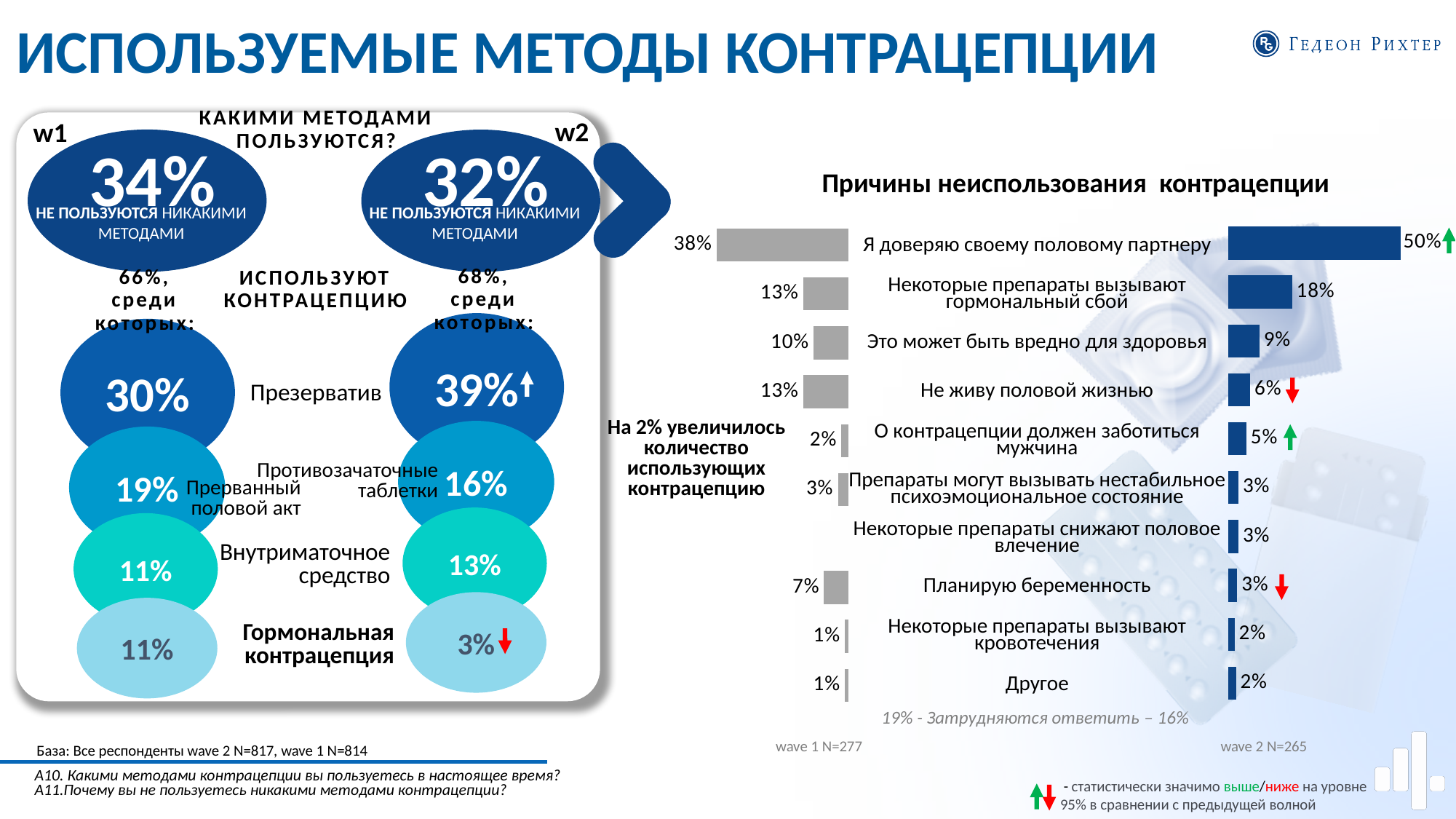
In the chart 'Причины неиспользования контрацепции', what is the wave 1 value for 'Не живу половой жизнью'? 13% In the left infographic 'Какими методами пользуются?', what share of respondents in w2 use no contraception methods? 32% In the chart 'Причины неиспользования контрацепции', what is the sample size shown for wave 2? N=265 What kind of chart is 'Причины неиспользования контрацепции'? bar chart In the chart 'Причины неиспользования контрацепции', what is the wave 1 value for 'Планирую беременность'? 7% In the chart 'Причины неиспользования контрацепции', what is the wave 2 value for 'Я доверяю своему половому партнеру'? 50% In the chart 'Причины неиспользования контрацепции', which reason has the highest wave 2 value? Я доверяю своему половому партнеру In the chart 'Причины неиспользования контрацепции', how many waves (series) are compared? 2 In the chart 'Причины неиспользования контрацепции', which is larger for 'Не живу половой жизнью': the wave 1 value or the wave 2 value? wave 1 In the chart 'Причины неиспользования контрацепции', how many reasons (categories) are listed as bars? 10 In the chart 'Причины неиспользования контрацепции', what is the wave 2 value for 'Планирую беременность'? 3% In the chart 'Причины неиспользования контрацепции', what is the difference between the wave 2 and wave 1 values for 'Я доверяю своему половому партнеру'? 12%